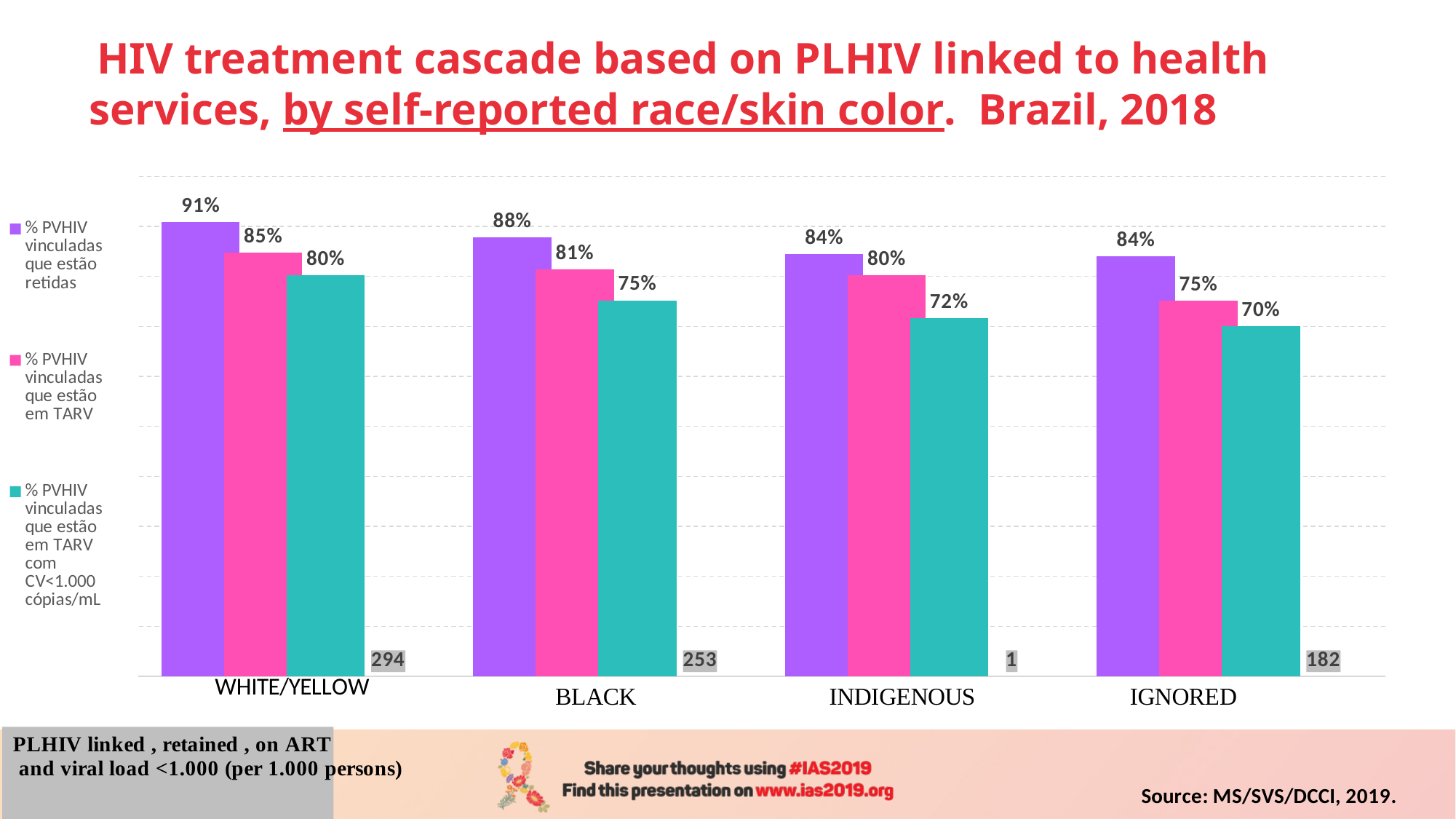
How many series does the legend list? 3 Which colour represents the '% PVHIV vinculadas que estão em TARV' series? pink What kind of chart is shown on the slide? bar chart What is the value of the '% PVHIV vinculadas que estão retidas' series for WHITE/YELLOW? 91% What is the value of the '% PVHIV vinculadas que estão em TARV' series for BLACK? 81% What is the value of the '% PVHIV vinculadas que estão em TARV com CV<1.000 cópias/mL' series for INDIGENOUS? 72% How many race/skin color categories are shown on the x axis? 4 Which category has the lowest value for the '% PVHIV vinculadas que estão em TARV com CV<1.000 cópias/mL' series? IGNORED What is the difference between the '% PVHIV vinculadas que estão retidas' value and the '% PVHIV vinculadas que estão em TARV com CV<1.000 cópias/mL' value for BLACK? 13% Which category has the highest value for the '% PVHIV vinculadas que estão retidas' series? WHITE/YELLOW Which is larger: the '% PVHIV vinculadas que estão em TARV' value for WHITE/YELLOW or for INDIGENOUS? WHITE/YELLOW What is the value of the '% PVHIV vinculadas que estão em TARV' series for IGNORED? 75%